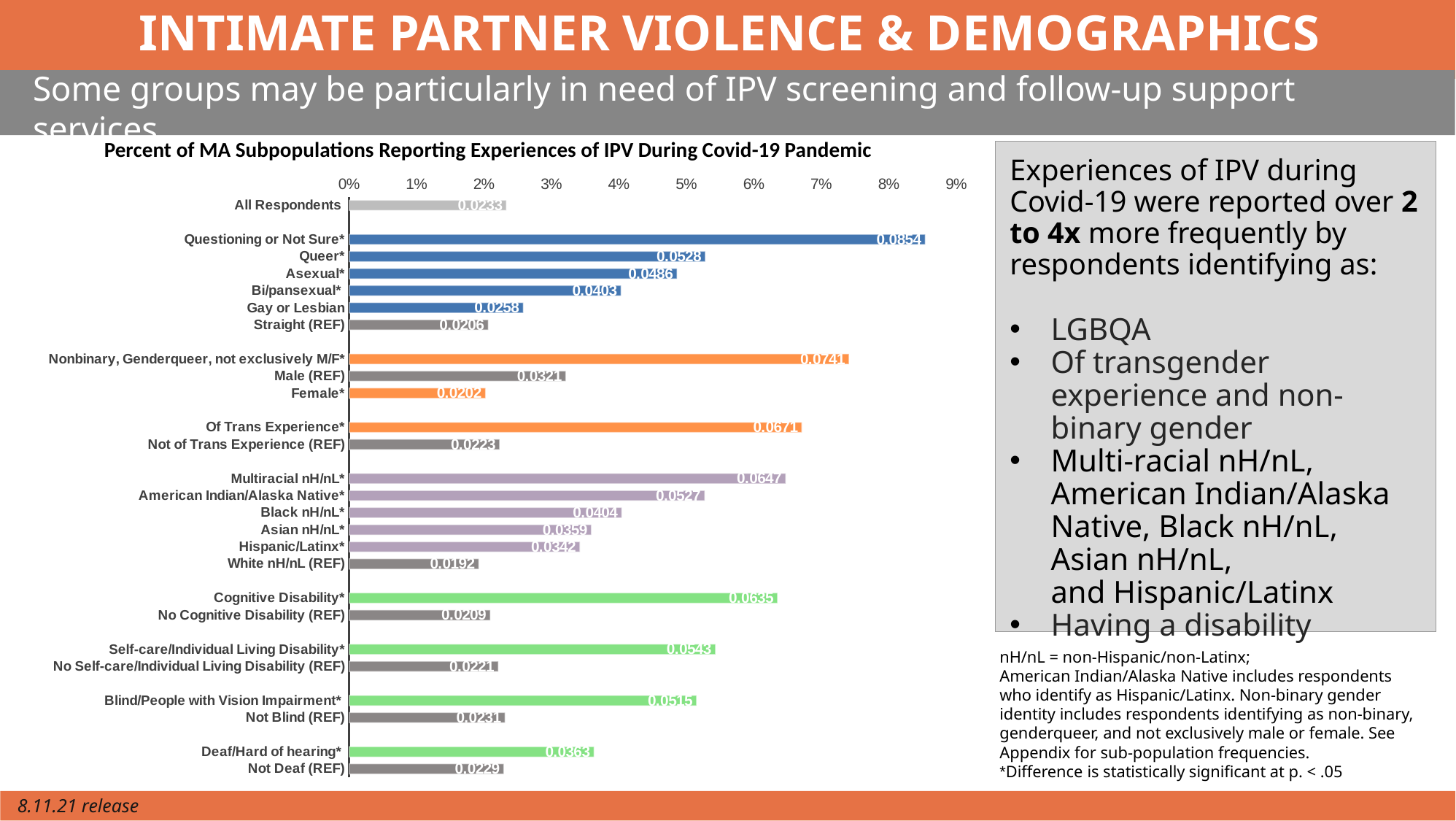
What value is shown for All Respondents? 0.0233 What value is shown for Questioning or Not Sure*? 0.0854 What is the difference between the values for Of Trans Experience* and Not of Trans Experience (REF)? 0.0448 Which category has the lowest value in the chart? White nH/nL (REF) Which has a larger value, Queer* or Asexual*? Queer* Is the value for Nonbinary, Genderqueer, not exclusively M/F* greater or less than 7%? greater How many categories are plotted in the chart? 26 What kind of chart is shown on the slide? Bar chart What value is shown for Cognitive Disability*? 0.0635 What value is shown for Male (REF)? 0.0321 Which category has the highest value in the chart? Questioning or Not Sure* What is the title of the chart? Percent of MA Subpopulations Reporting Experiences of IPV During Covid-19 Pandemic